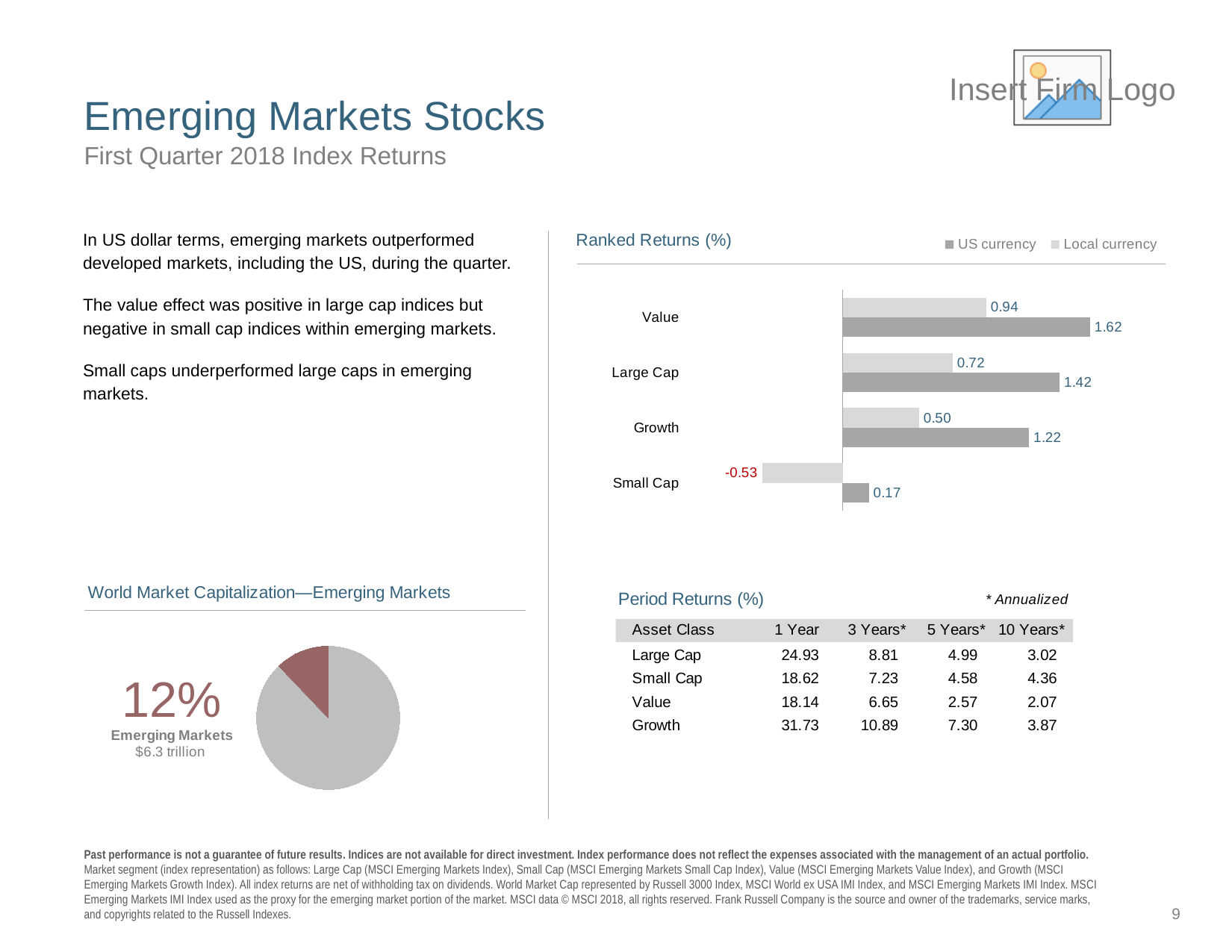
In the Ranked Returns (%) chart, which category has the lowest Local currency return? Small Cap In the Ranked Returns (%) chart, what is the difference between the US currency and Local currency returns for Large Cap? 0.70 How many series does the legend of the Ranked Returns (%) chart list? 2 What kind of chart is the Ranked Returns (%) chart? Bar chart In the Ranked Returns (%) chart, what is the Local currency return for Small Cap? -0.53 In the Ranked Returns (%) chart, what is the Local currency return for Growth? 0.50 In the Ranked Returns (%) chart, which category has the highest US currency return? Value In the Ranked Returns (%) chart, which is larger for Growth: the US currency return or the Local currency return? US currency What kind of chart is the World Market Capitalization—Emerging Markets chart? Pie chart In the Ranked Returns (%) chart, what is the US currency return for Value? 1.62 How many categories are shown in the Ranked Returns (%) chart? 4 In the World Market Capitalization—Emerging Markets chart, what share of the pie do Emerging Markets represent? 12%